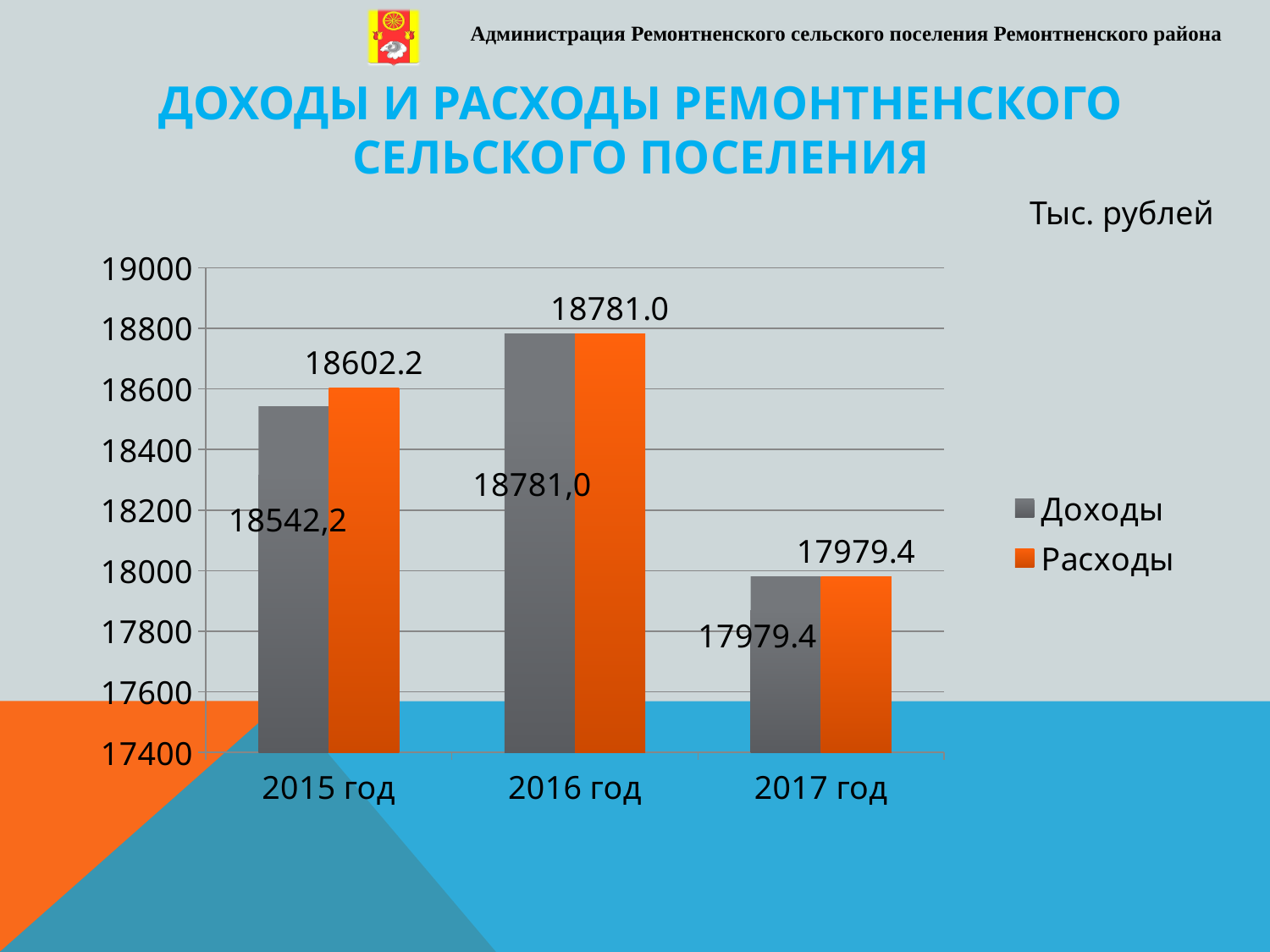
How many years are shown on the x axis? 3 Is the value of Доходы for 2015 год greater or less than 18600? less How many series does the legend list? 2 What is the value of Доходы for 2015 год? 18542,2 In which year is Расходы the highest? 2016 год In which year is Доходы the lowest? 2017 год What kind of chart is shown on the slide? bar chart What is the value of Доходы for 2017 год? 17979.4 What is the value of Расходы for 2016 год? 18781.0 In 2015 год, which is larger: Доходы or Расходы? Расходы What is the value of Расходы for 2015 год? 18602.2 What is the difference between Расходы and Доходы in 2015 год? 60.0